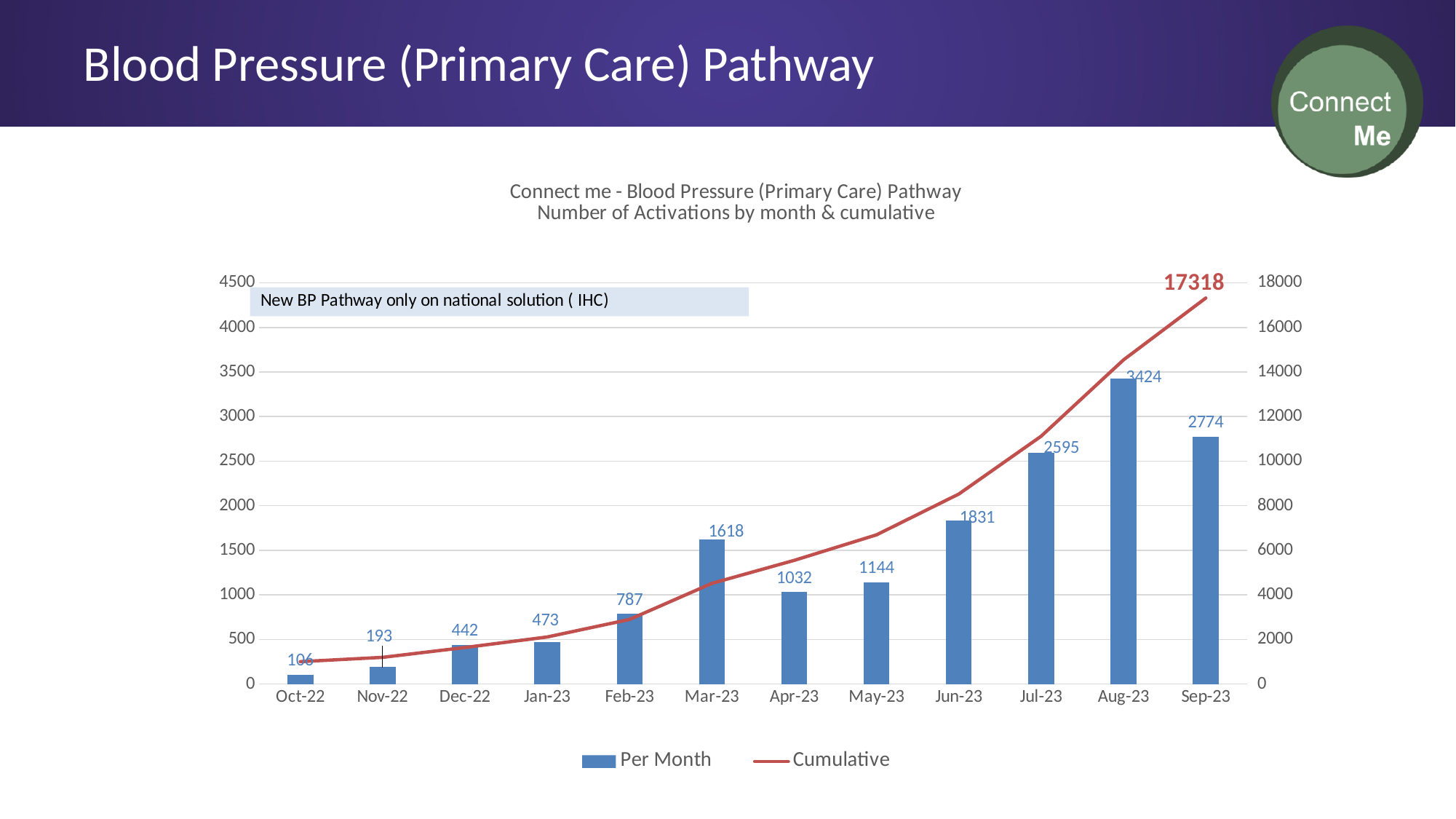
How many months are shown on the x axis? 12 Is the Cumulative value for Jun-23 greater or less than 10000? less What is the difference between the Per Month values for Aug-23 and Sep-23? 650 What is the Per Month value for Mar-23? 1618 What is the Cumulative value shown for Sep-23? 17318 Which is larger, the Per Month value for Apr-23 or for May-23? May-23 Which month has the lowest Per Month value? Oct-22 Which month has the highest Per Month value? Aug-23 What does the text box inside the chart say? New BP Pathway only on national solution ( IHC) How many series does the legend list? 2 What is the Per Month value for Aug-23? 3424 Does the Cumulative line rise or fall from Oct-22 to Sep-23? rise